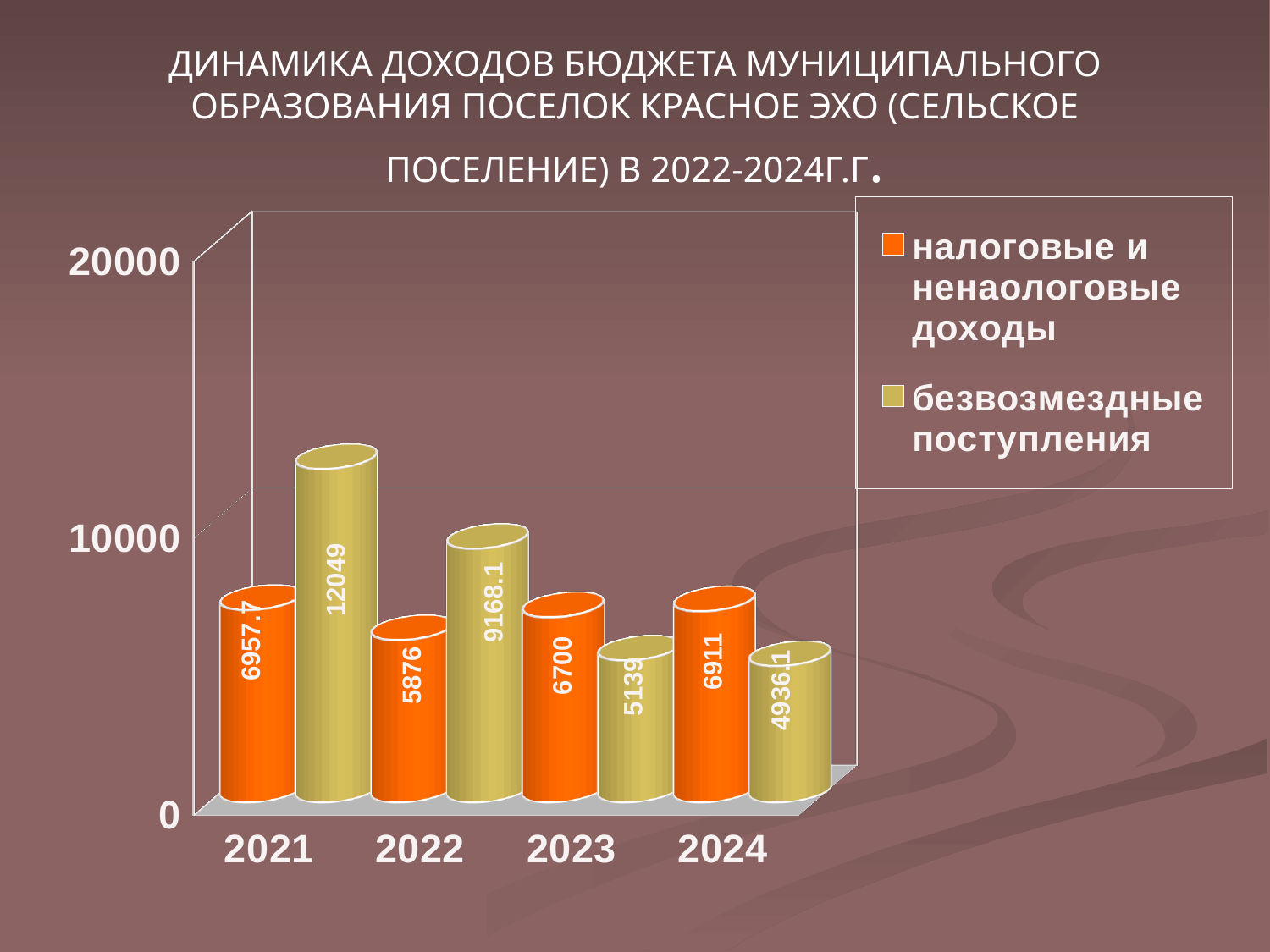
In which year is налоговые и ненаологовые доходы lowest? 2022 In which year is безвозмездные поступления highest? 2021 What is the value of безвозмездные поступления for 2022? 9168.1 Does безвозмездные поступления rise or fall from 2021 to 2024? fall How many years are shown on the x axis? 4 What is the value of налоговые и ненаологовые доходы for 2021? 6957.7 What is the difference between безвозмездные поступления in 2021 and in 2022? 2880.9 What is the value of безвозмездные поступления for 2024? 4936.1 What is the value of налоговые и ненаологовые доходы for 2023? 6700 Which is larger in 2023: налоговые и ненаологовые доходы or безвозмездные поступления? налоговые и ненаологовые доходы Is the value of безвозмездные поступления for 2021 greater or less than 10000? greater How many series does the legend list? 2